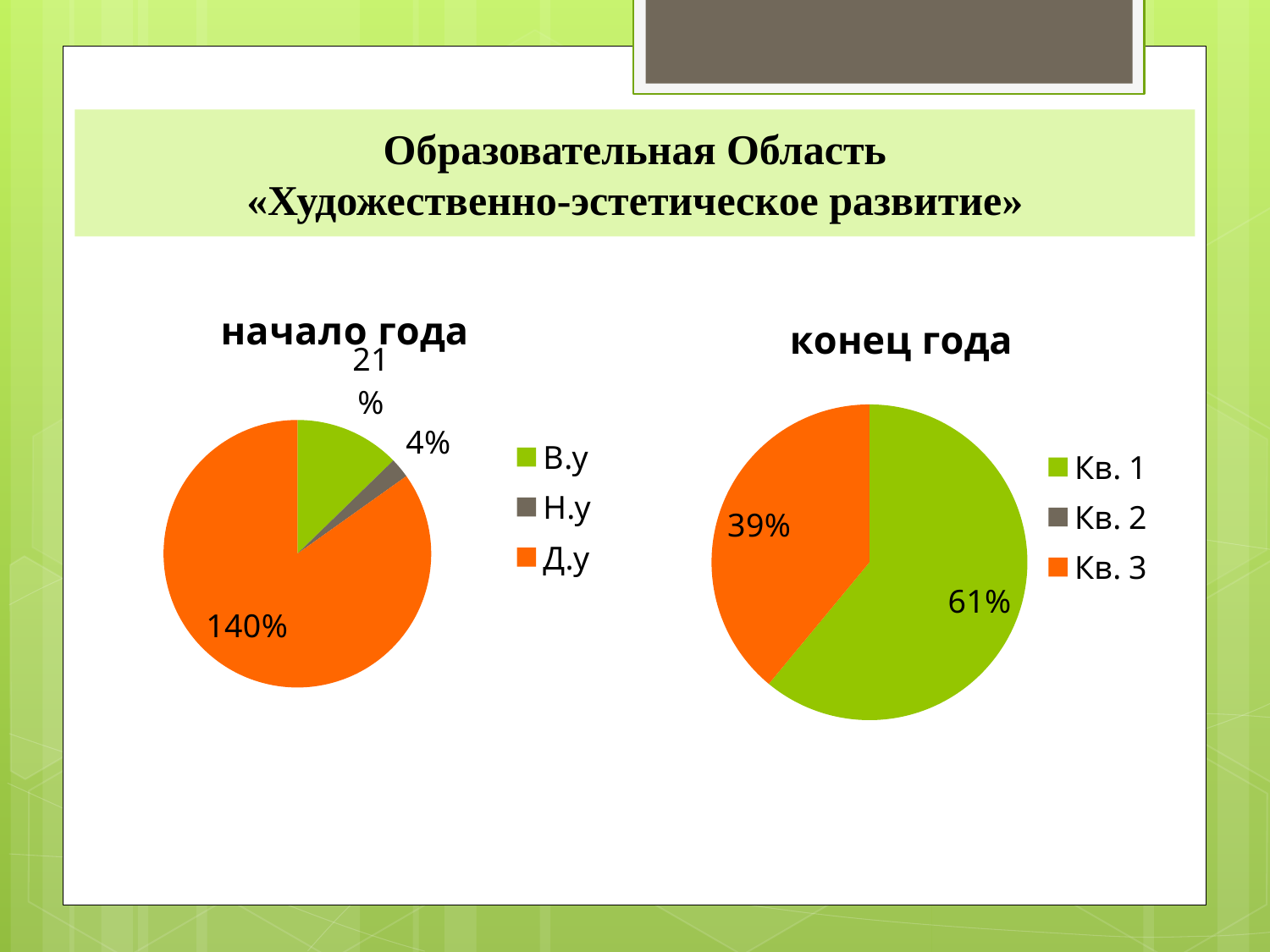
In the chart titled «начало года», which category has the smallest slice? Н.у In the chart titled «конец года», what is the value shown for Кв. 3? 39% In the chart titled «начало года», which category has the largest slice? Д.у In the chart titled «конец года», what is the value shown for Кв. 1? 61% What type of chart is the chart titled «конец года»? Pie chart In the chart titled «конец года», what colour is the slice for Кв. 3? Orange In the chart titled «конец года», what is the difference between the values for Кв. 1 and Кв. 3? 22% How many entries does the legend of the chart titled «начало года» list? 3 In the chart titled «начало года», what is the value shown for В.у? 21% In the chart titled «начало года», what is the value shown for Д.у? 140% In the chart titled «конец года», which is larger, Кв. 1 or Кв. 3? Кв. 1 In the chart titled «начало года», what is the value shown for Н.у? 4%